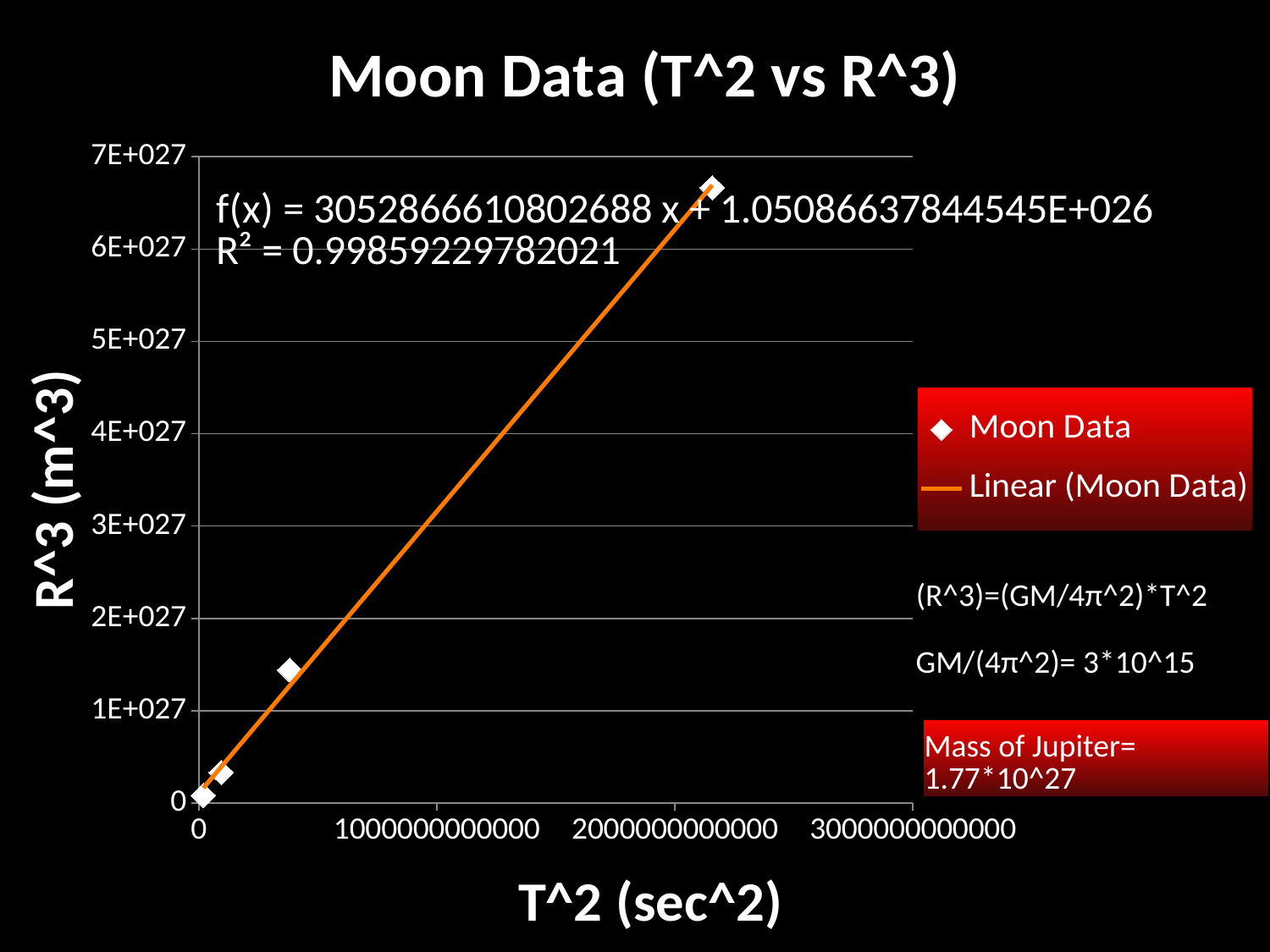
Do the R^3 values rise or fall as T^2 increases along the x axis? rise What are the two entries in the chart's legend? Moon Data and Linear (Moon Data) What is the title of the chart? Moon Data (T^2 vs R^3) Is the R^3 value of the highest plotted data point greater or less than 6E+027? greater What is the label of the x axis? T^2 (sec^2) What kind of chart is shown on the slide? scatter chart What is the trendline equation displayed on the chart? f(x) = 3052866610802688 x + 1.05086637844545E+026 What is the label of the y axis? R^3 (m^3) What is the R² value shown on the chart? 0.99859229782021 How many data points are plotted for the Moon Data series? 4 How many entries does the chart's legend list? 2 Is the R^3 value of the second-highest plotted data point greater or less than 2E+027? less